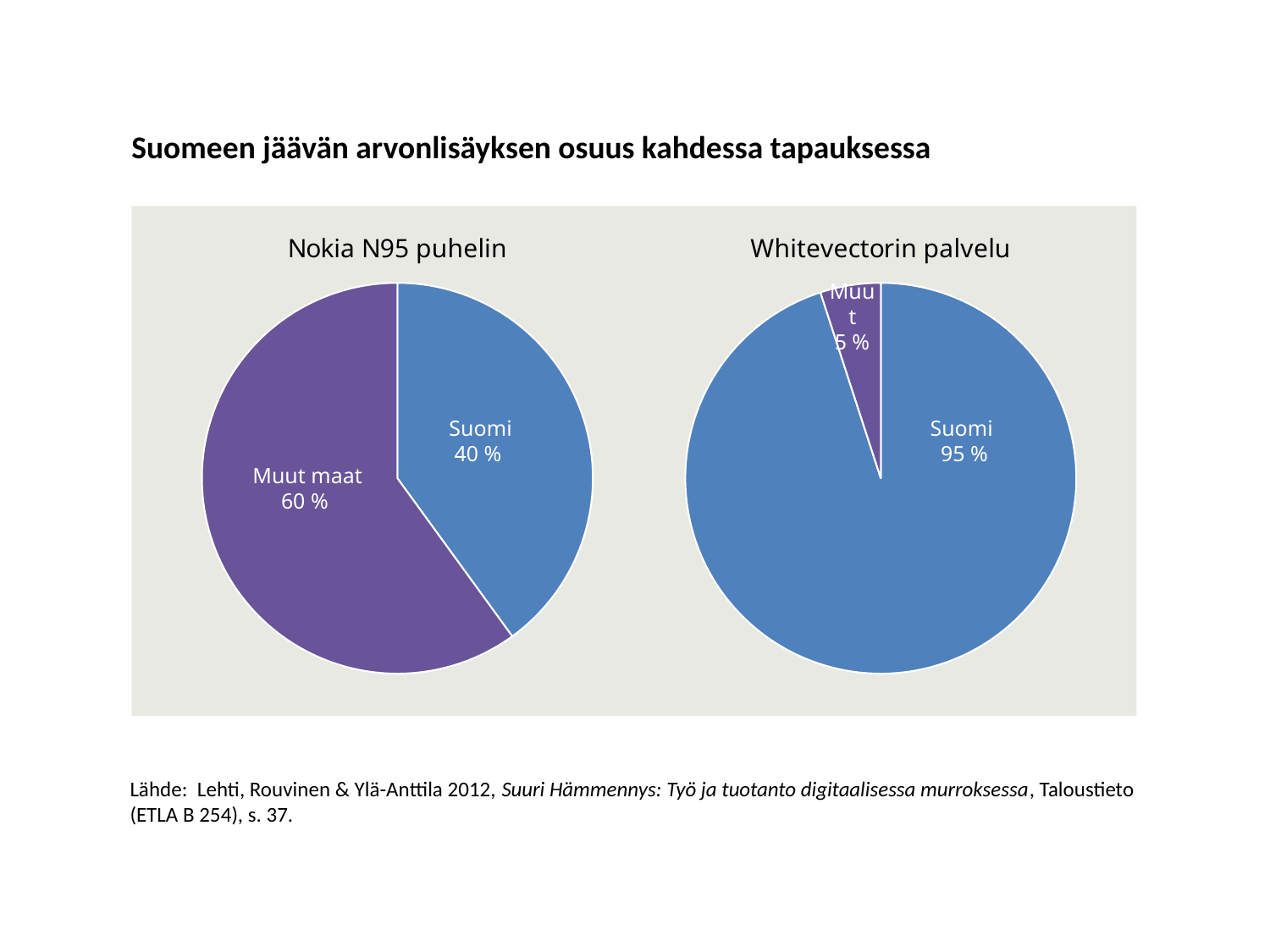
In the 'Nokia N95 puhelin' pie chart, what share does Muut maat have? 60 % In the 'Whitevectorin palvelu' pie chart, what is the difference between the Suomi share and the Muut share? 90 % In the 'Whitevectorin palvelu' pie chart, what share does Muut have? 5 % In the 'Whitevectorin palvelu' pie chart, which slice is the smallest? Muut How many slices does the 'Nokia N95 puhelin' pie chart have? 2 In the 'Nokia N95 puhelin' pie chart, what share does Suomi have? 40 % In the 'Whitevectorin palvelu' pie chart, what share does Suomi have? 95 % What is the title of the chart on the left of the slide? Nokia N95 puhelin In the 'Nokia N95 puhelin' pie chart, what is the difference between the Muut maat share and the Suomi share? 20 % In the 'Nokia N95 puhelin' pie chart, which slice is the largest? Muut maat Is the Suomi share larger in the 'Nokia N95 puhelin' chart or in the 'Whitevectorin palvelu' chart? Whitevectorin palvelu What type of chart is used for 'Whitevectorin palvelu'? Pie chart